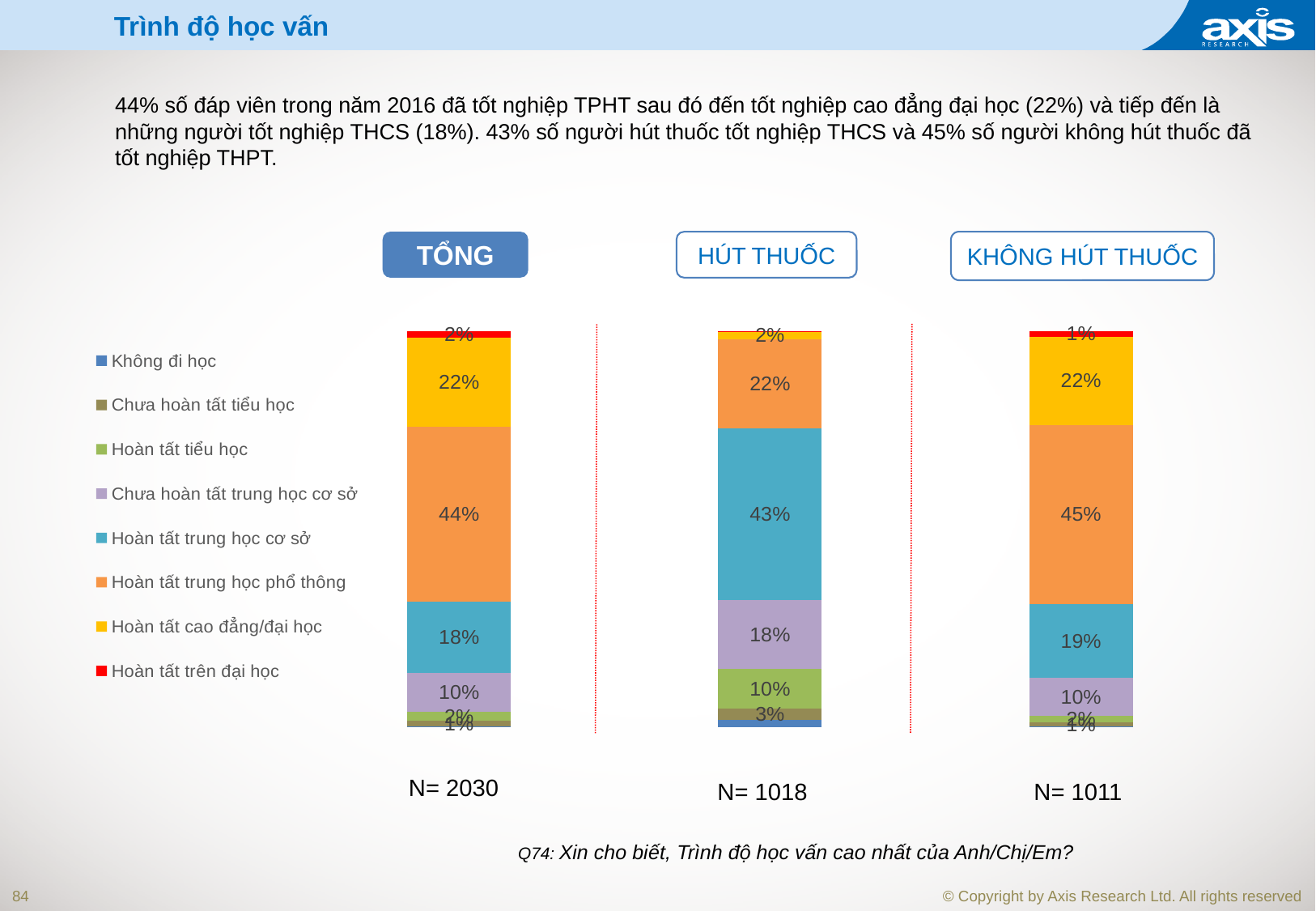
In the TỔNG chart, what is the difference between Hoàn tất trung học phổ thông and Hoàn tất trung học cơ sở? 26 percentage points In the HÚT THUỐC chart, what percentage is shown for Hoàn tất tiểu học? 10% What kind of chart is used on this slide? Stacked bar chart In the HÚT THUỐC chart, what percentage is shown for Hoàn tất trung học cơ sở? 43% How many education levels does the legend list? 8 In the KHÔNG HÚT THUỐC chart, what percentage is shown for Hoàn tất trung học cơ sở? 19% In the TỔNG chart, what percentage is shown for Hoàn tất cao đẳng/đại học? 22% In the TỔNG chart, what percentage is shown for Hoàn tất trung học phổ thông? 44% In the HÚT THUỐC chart, which is larger: Hoàn tất trung học cơ sở or Hoàn tất trung học phổ thông? Hoàn tất trung học cơ sở What is the sample size (N) shown under the HÚT THUỐC chart? N= 1018 In the TỔNG chart, which education level has the largest share? Hoàn tất trung học phổ thông In the KHÔNG HÚT THUỐC chart, what percentage is shown for Hoàn tất trung học phổ thông? 45%